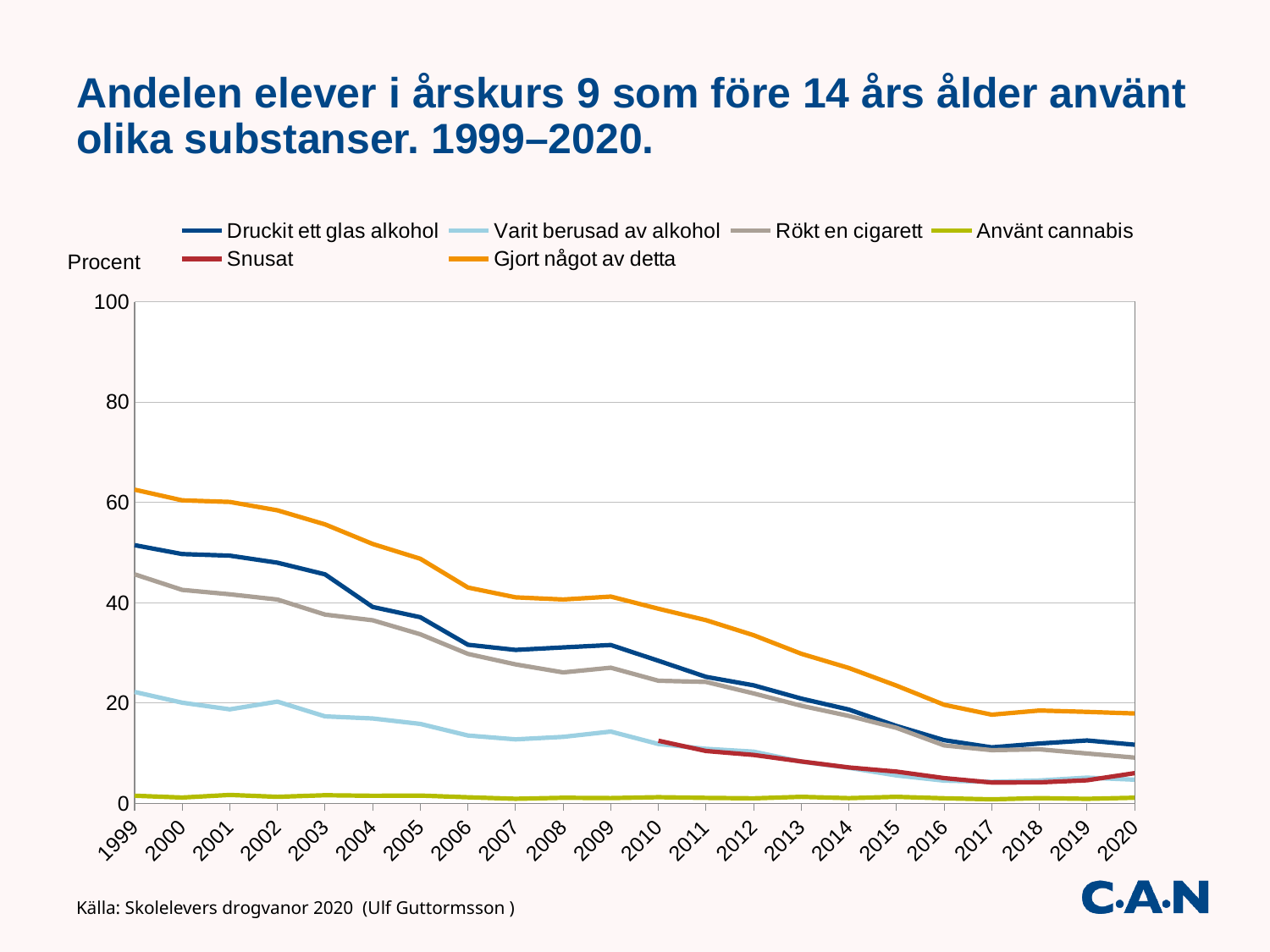
In 1999, which is larger: Druckit ett glas alkohol or Varit berusad av alkohol? Druckit ett glas alkohol Does the Gjort något av detta series rise or fall from 1999 to 2020? fall Which series has the highest value in 1999? Gjort något av detta What label is shown on the y axis? Procent How many series does the legend list? 6 Is the value for Rökt en cigarett in 2020 greater or less than 20? less Is the value for Gjort något av detta in 1999 greater or less than 60? greater Which series has the lowest value in 2020? Använt cannabis How many years are shown along the x axis? 22 Is the value for Gjort något av detta in 2020 greater or less than 20? less What kind of chart is shown on the slide? line chart